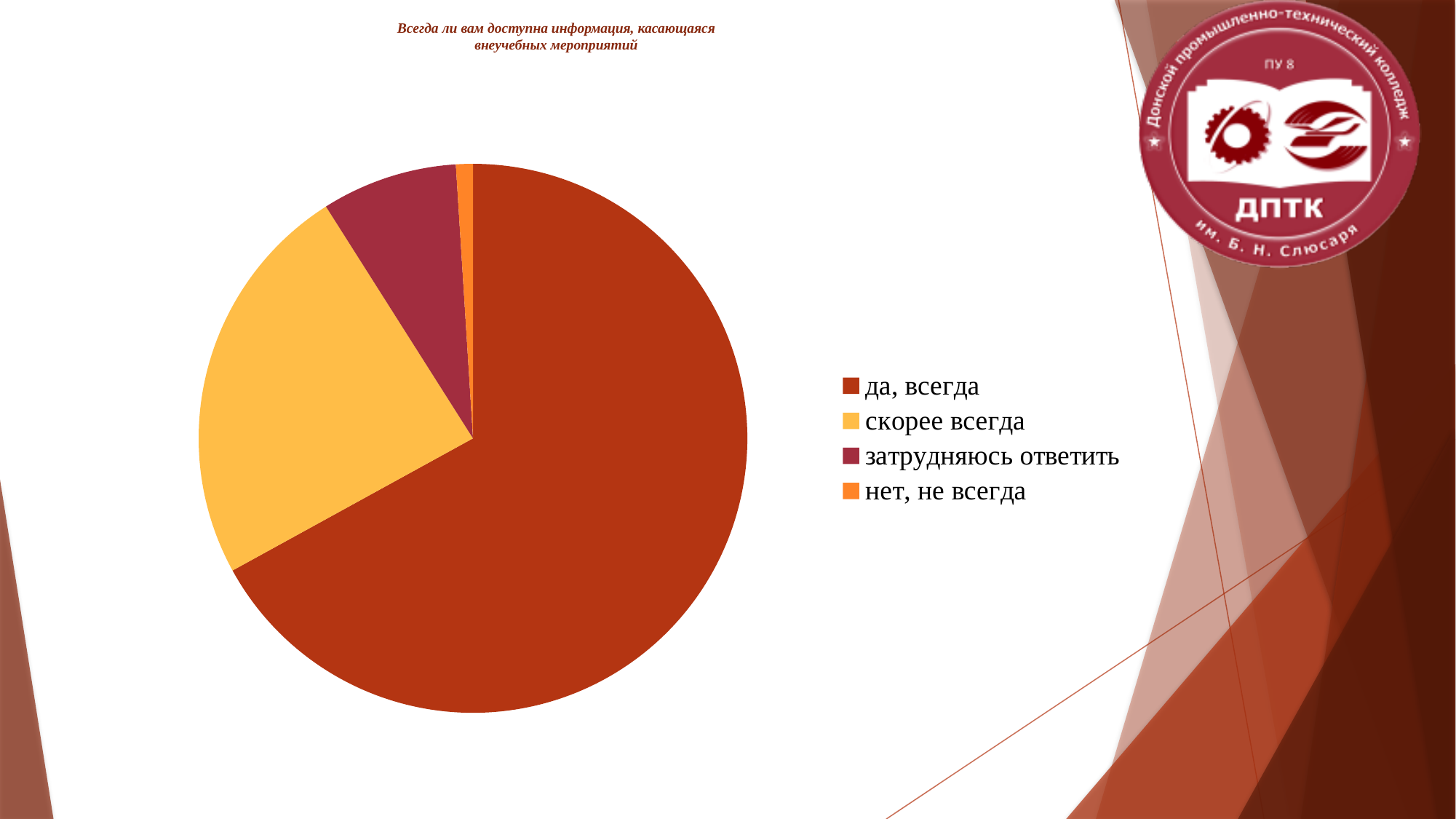
What kind of chart is shown on the slide? pie chart Which slice is larger: "затрудняюсь ответить" or "нет, не всегда"? затрудняюсь ответить Which slice is larger: "скорее всегда" or "затрудняюсь ответить"? скорее всегда Which category has the largest slice of the pie? да, всегда What is the title of the chart? Всегда ли вам доступна информация, касающаяся внеучебных мероприятий How many slices does the pie chart have? 4 Which category is shown in yellow in the pie chart? скорее всегда Which slice is larger: "да, всегда" or "скорее всегда"? да, всегда How many entries does the legend list? 4 Which category has the smallest slice of the pie? нет, не всегда